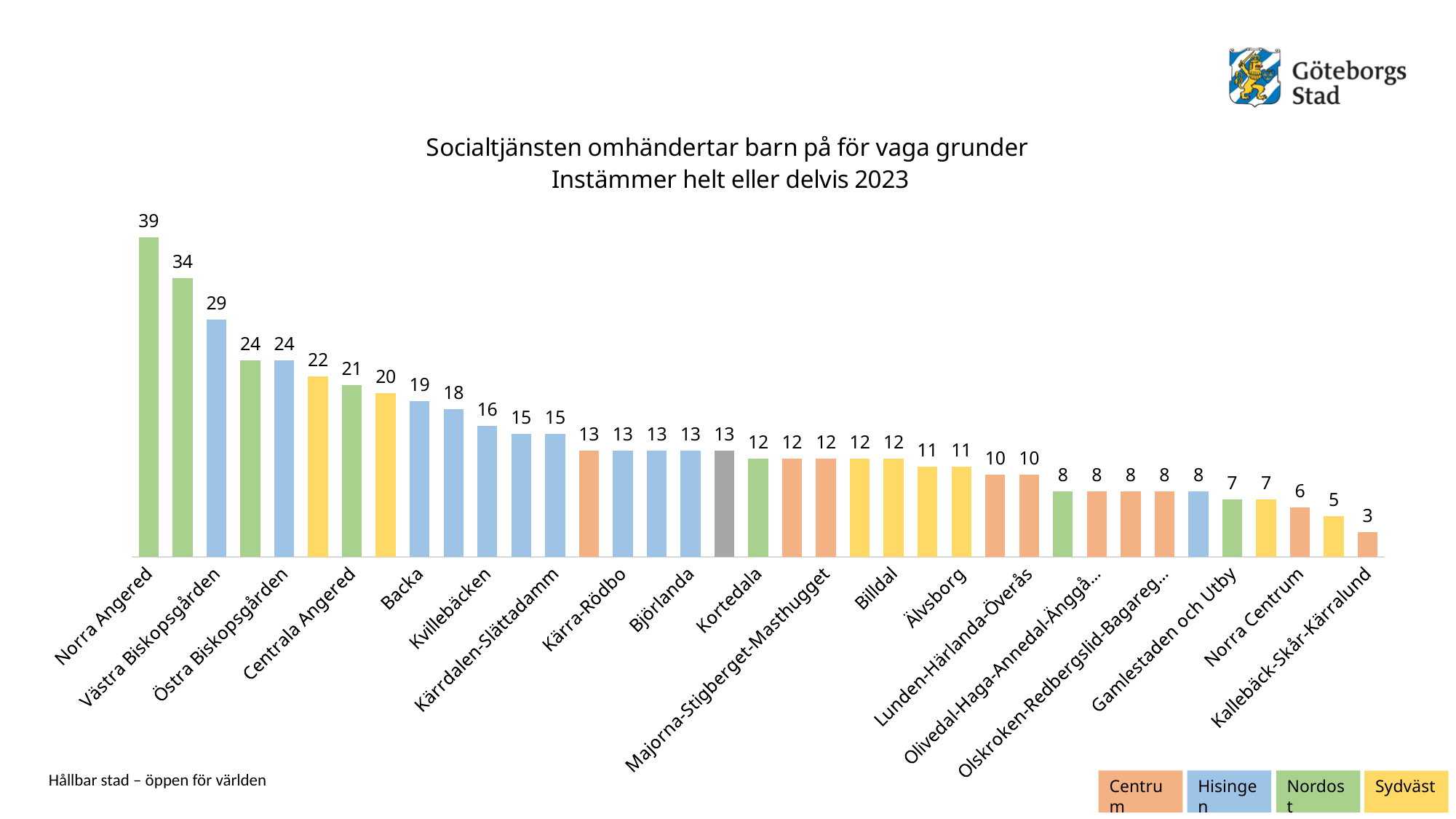
Which category has the highest value? Norra Angered What is the value for Norra Angered? 39 Which category has the lowest value? Kallebäck-Skår-Kärralund What kind of chart is shown on the slide? Bar chart What is the value for Lunden-Härlanda-Överås? 10 What is the value for Backa? 19 What is the difference between the values for Norra Angered and Kallebäck-Skår-Kärralund? 36 How many entries does the legend list? 4 What is the value for Kallebäck-Skår-Kärralund? 3 Which has a larger value, Backa or Kvillebäcken? Backa Do the values rise or fall from left to right along the x axis? Fall What is the value for Kvillebäcken? 16